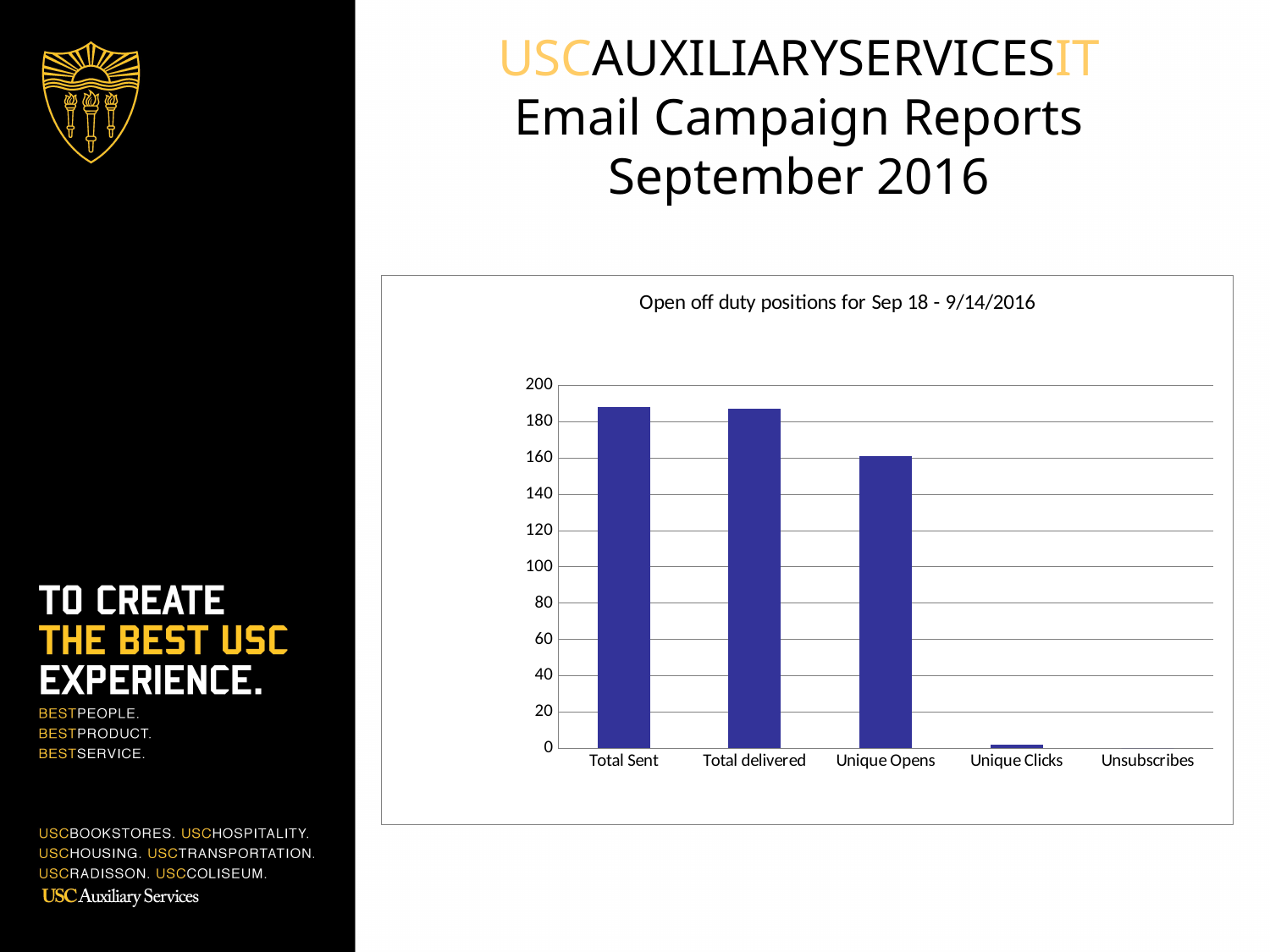
Which category has the lowest value in the chart? Unsubscribes What is the highest value shown on the vertical axis of the chart? 200 Do the values rise or fall moving from left to right along the x axis? fall Is the value for Unique Clicks greater or less than 20? less Is the value for Total delivered greater or less than 180? greater Is the value for Unique Opens greater or less than 180? less How many categories are shown on the x axis of the chart? 5 What is the title of the chart? Open off duty positions for Sep 18 - 9/14/2016 Which is larger, the value for Total Sent or the value for Unique Opens? Total Sent What kind of chart is shown on the slide? bar chart